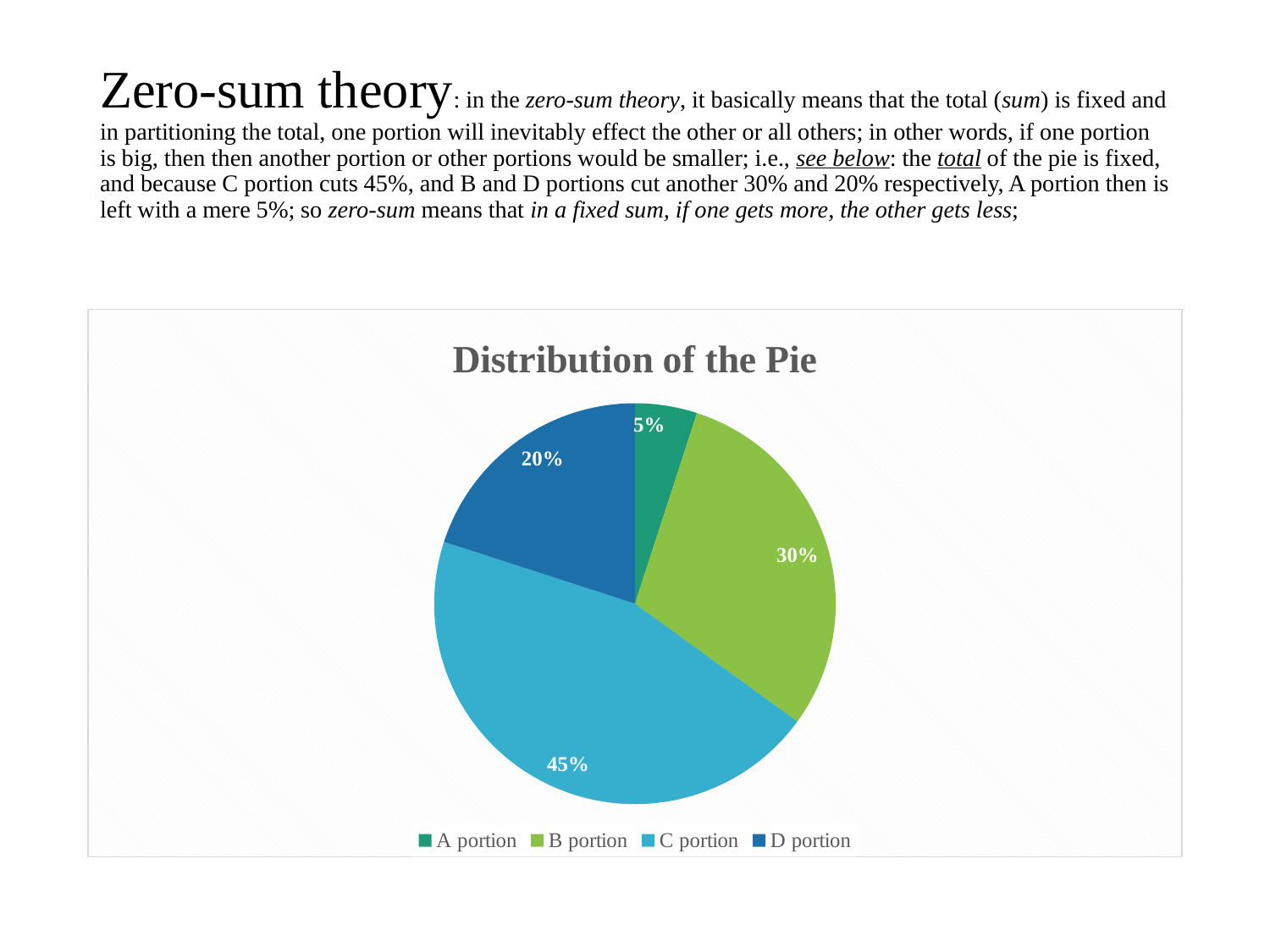
What percentage of the pie does D portion take? 20% What percentage of the pie does C portion take? 45% Which portion has the smallest share of the pie? A portion What percentage of the pie does A portion take? 5% What is the difference in percentage points between C portion and B portion? 15 What percentage of the pie does B portion take? 30% What type of chart is shown on the slide? pie chart Which is larger, B portion or D portion? B portion How many entries does the legend list? 4 What is the title of the chart? Distribution of the Pie Which portion has the largest share of the pie? C portion How many slices does the pie chart have? 4